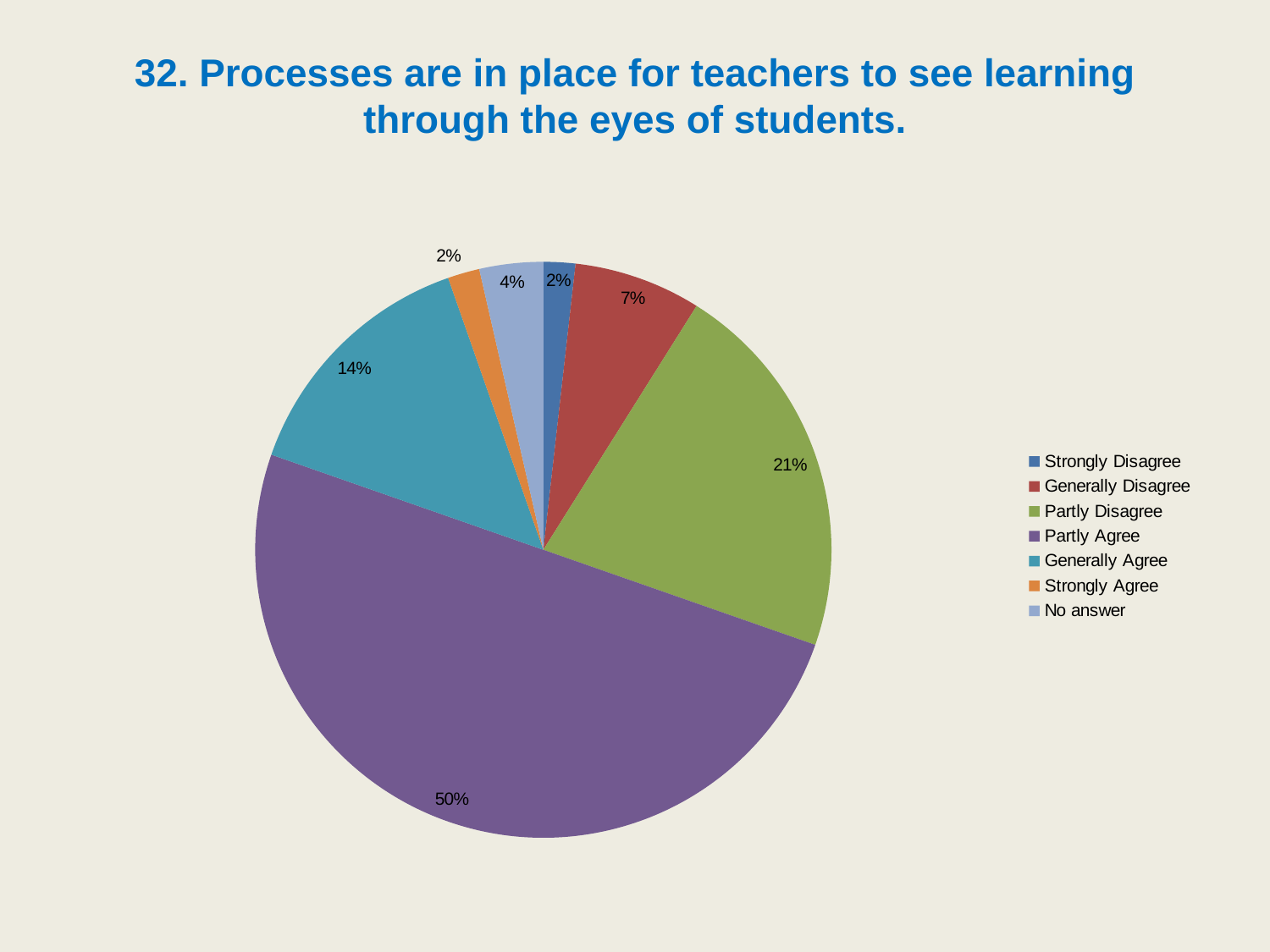
Which response category has the largest share of the pie? Partly Agree What percentage of respondents chose Generally Agree? 14% What colour is the Partly Agree slice? Purple What percentage of respondents chose Generally Disagree? 7% Which is larger, the share for Generally Agree or the share for Generally Disagree? Generally Agree What is the difference in percentage points between Partly Agree and Partly Disagree? 29 What percentage of respondents chose Partly Disagree? 21% How many categories does the legend list? 7 What percentage of respondents chose Partly Agree? 50% What kind of chart is shown on the slide? Pie chart What is the combined share of Strongly Disagree and Strongly Agree? 4% What percentage of respondents gave No answer? 4%